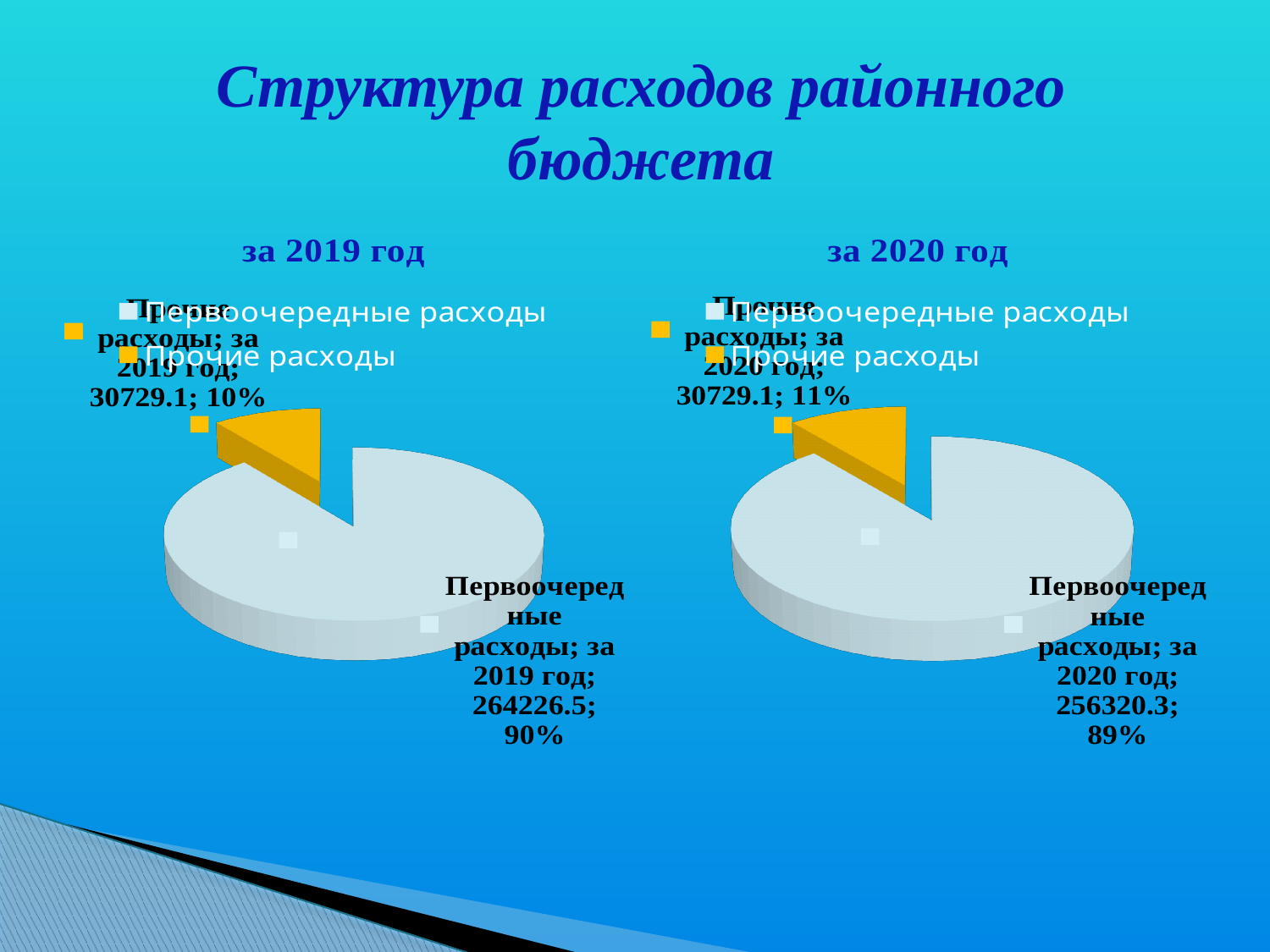
In the chart for 2020 (за 2020 год), which category is the largest? Первоочередные расходы In the chart for 2019 (за 2019 год), what share of the pie is Первоочередные расходы? 90% How many categories does the chart for 2020 (за 2020 год) show? 2 In the chart for 2019 (за 2019 год), which category is the smallest? Прочие расходы In the chart for 2019 (за 2019 год), what is the value for Первоочередные расходы? 264226.5 Which is larger: Первоочередные расходы for 2019 or Первоочередные расходы for 2020? Первоочередные расходы for 2019 In the chart for 2019 (за 2019 год), what is the difference between Первоочередные расходы and Прочие расходы? 233497.4 In the chart for 2019 (за 2019 год), what is the value for Прочие расходы? 30729.1 What kind of chart is the chart for 2019 (за 2019 год)? Pie chart In the chart for 2020 (за 2020 год), what share of the pie is Прочие расходы? 11% In the chart for 2020 (за 2020 год), what is the value for Прочие расходы? 30729.1 In the chart for 2020 (за 2020 год), what is the value for Первоочередные расходы? 256320.3